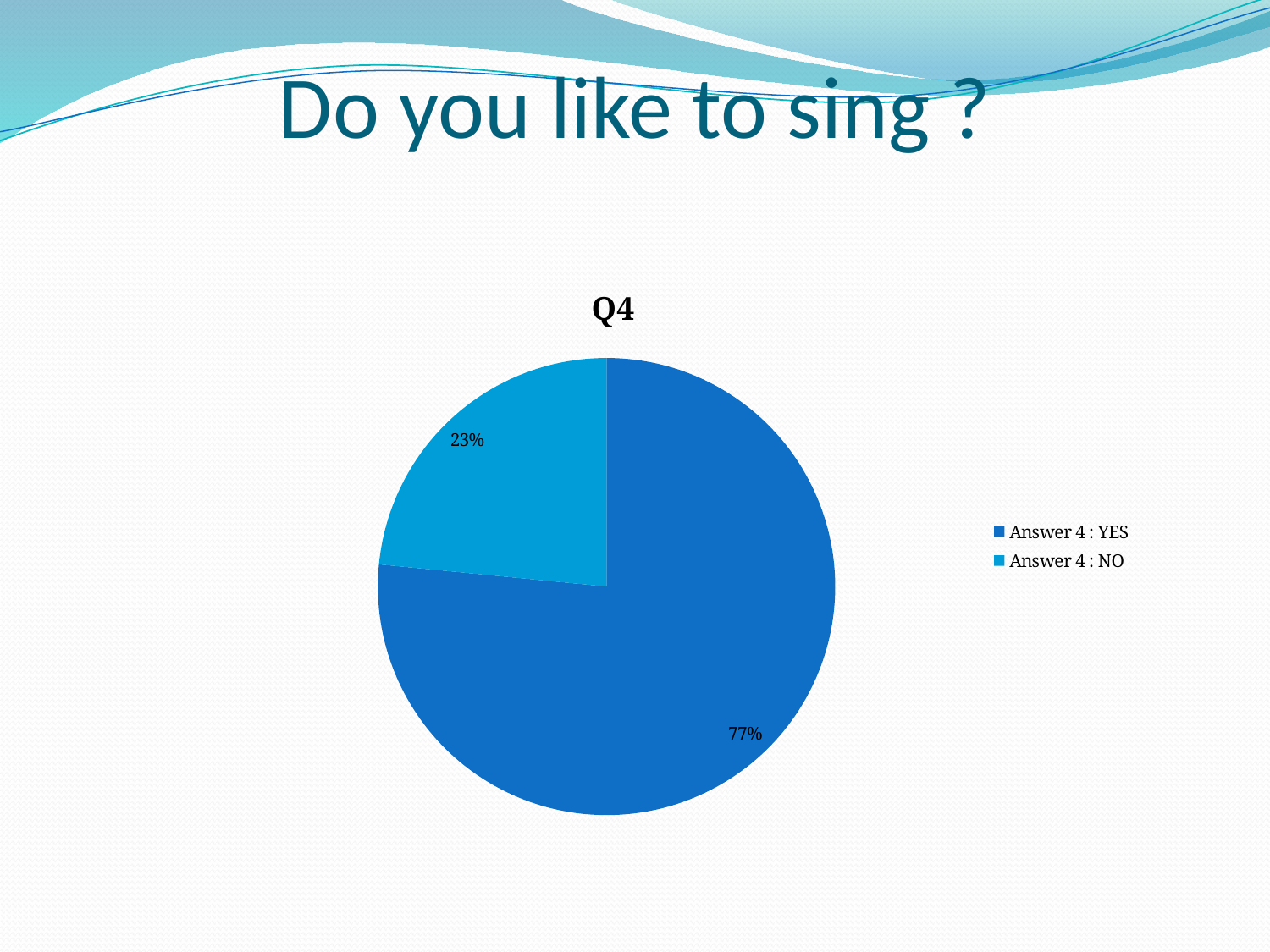
Which is larger, the YES slice or the NO slice? Answer 4 : YES How many entries does the legend list? 2 Which slice is the smallest? Answer 4 : NO How many slices does the pie chart have? 2 What share of the pie is labelled "Answer 4 : NO"? 23% Is the share for "Answer 4 : YES" greater or less than 50%? greater What is the value printed on the darker blue slice? 77% What share of the pie is labelled "Answer 4 : YES"? 77% What kind of chart is shown on the slide? pie chart What is the difference in percentage points between the YES and NO slices? 54 Which slice is the largest? Answer 4 : YES What is the chart's title? Q4